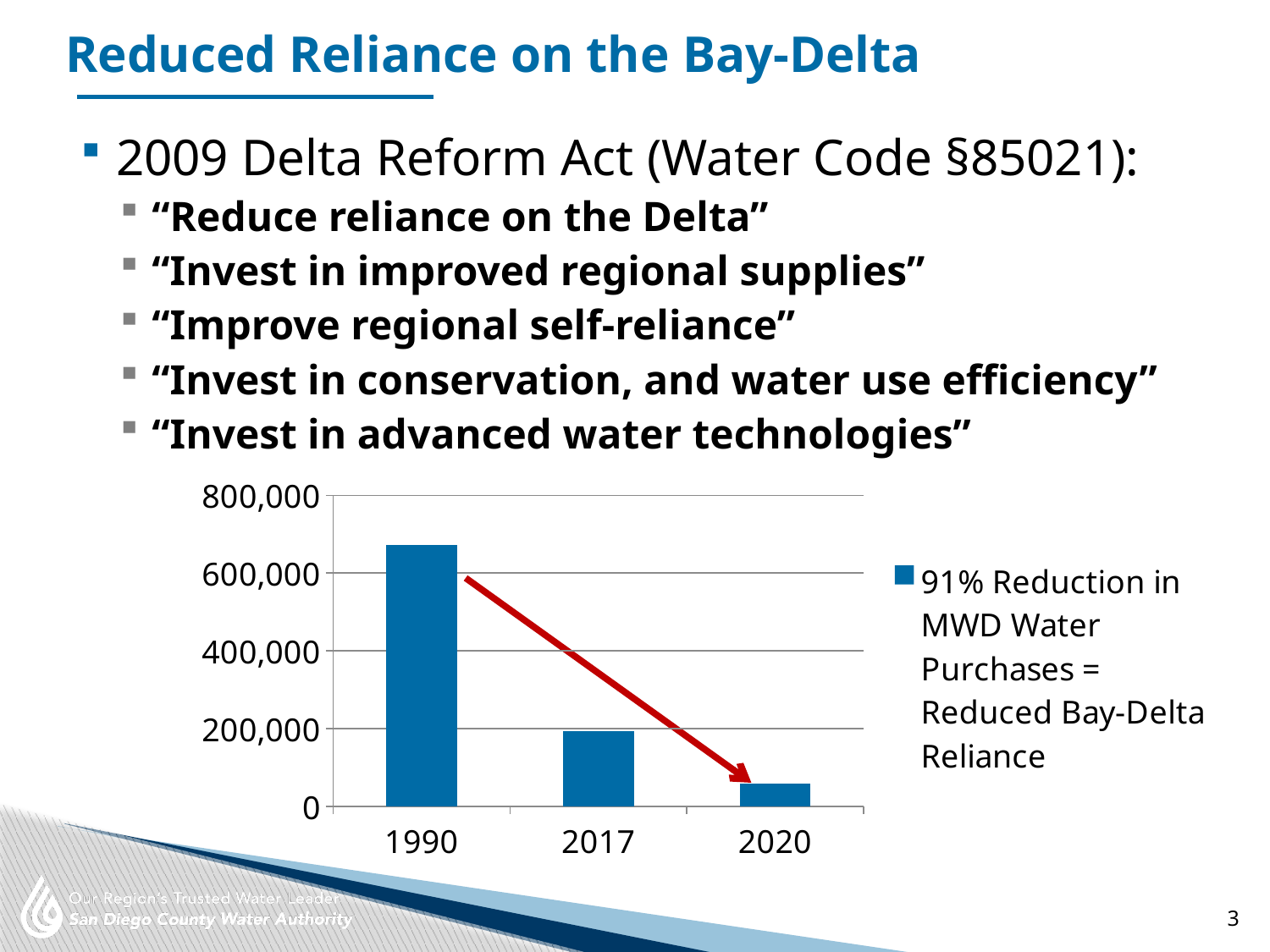
Which bar is taller, 2017 or 2020? 2017 Which year has the highest bar in the chart? 1990 Is the value for 2017 greater or less than 400,000? less Which bar is taller, 1990 or 2017? 1990 How many series does the chart's legend list? 1 Is the value for 1990 greater or less than 600,000? greater Is the value for 2020 greater or less than 200,000? less What is the legend entry shown next to the chart? 91% Reduction in MWD Water Purchases = Reduced Bay-Delta Reliance Do the bar values rise or fall from 1990 to 2020? fall What kind of chart is shown on the slide? bar chart Which year has the lowest bar in the chart? 2020 How many categories are plotted on the x axis of the chart? 3